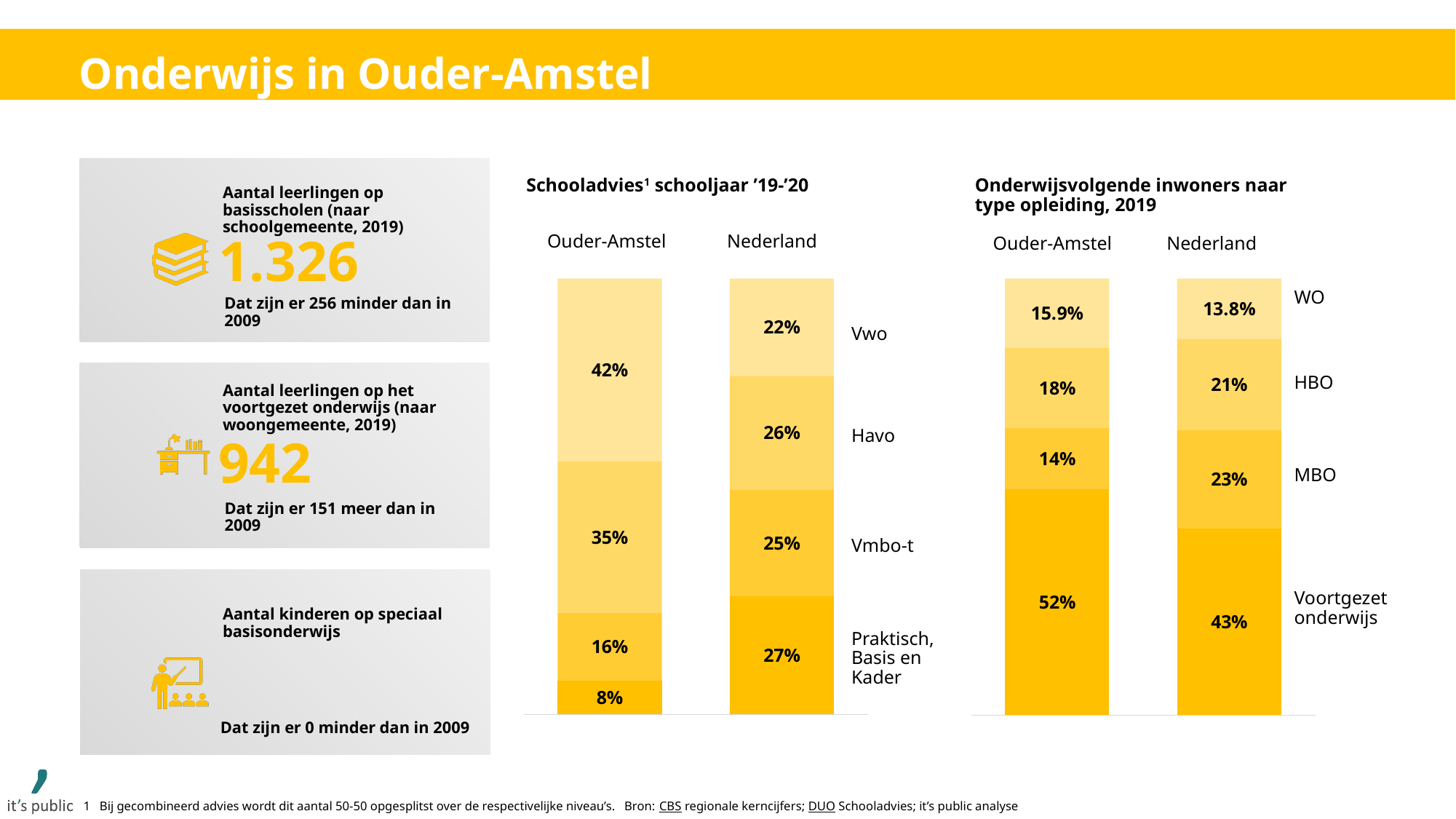
In the 'Schooladvies schooljaar '19-'20' chart, what is the difference between the Havo shares of Ouder-Amstel and Nederland? 9% In the 'Onderwijsvolgende inwoners naar type opleiding, 2019' chart, what is the MBO share for Nederland? 23% In the 'Schooladvies schooljaar '19-'20' chart, which has a larger Vmbo-t share, Ouder-Amstel or Nederland? Nederland In the 'Schooladvies schooljaar '19-'20' chart, what is the Vwo share for Ouder-Amstel? 42% What kind of chart is 'Onderwijsvolgende inwoners naar type opleiding, 2019'? Stacked bar chart In the 'Onderwijsvolgende inwoners naar type opleiding, 2019' chart, what is the difference between the Voortgezet onderwijs shares of Ouder-Amstel and Nederland? 9% In the 'Onderwijsvolgende inwoners naar type opleiding, 2019' chart, which has a larger HBO share, Ouder-Amstel or Nederland? Nederland In the 'Schooladvies schooljaar '19-'20' chart, what is the Praktisch, Basis en Kader share for Nederland? 27% In the 'Onderwijsvolgende inwoners naar type opleiding, 2019' chart, what is the WO share for Ouder-Amstel? 15.9% In the 'Schooladvies schooljaar '19-'20' chart, which segment is the smallest in the Ouder-Amstel bar? Praktisch, Basis en Kader In the 'Onderwijsvolgende inwoners naar type opleiding, 2019' chart, which segment is the largest in the Nederland bar? Voortgezet onderwijs In the 'Schooladvies schooljaar '19-'20' chart, how many segments make up each stacked bar? 4